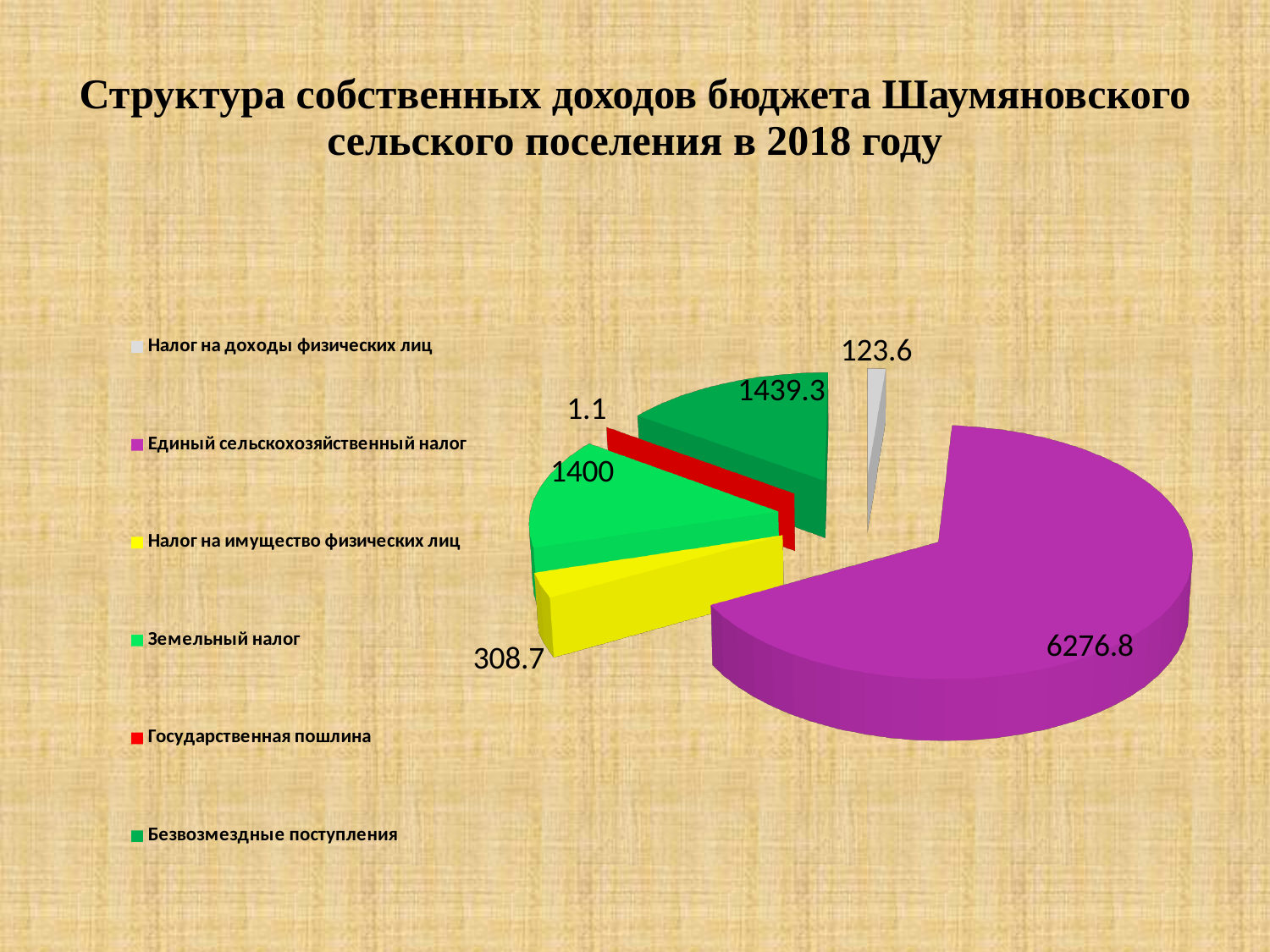
What is the value for Безвозмездные поступления? 1439.3 Which category has the smallest slice of the pie? Государственная пошлина Which category has the largest slice of the pie? Единый сельскохозяйственный налог What is the value for Налог на имущество физических лиц? 308.7 What is the difference between the values for Безвозмездные поступления and Земельный налог? 39.3 How many categories does the pie chart show? 6 What type of chart is shown on the slide? Pie chart What is the value for Налог на доходы физических лиц? 123.6 Which is larger: Земельный налог or Безвозмездные поступления? Безвозмездные поступления What is the value for Единый сельскохозяйственный налог? 6276.8 What colour is the slice for Государственная пошлина? Red What is the difference between the values for Налог на имущество физических лиц and Налог на доходы физических лиц? 185.1